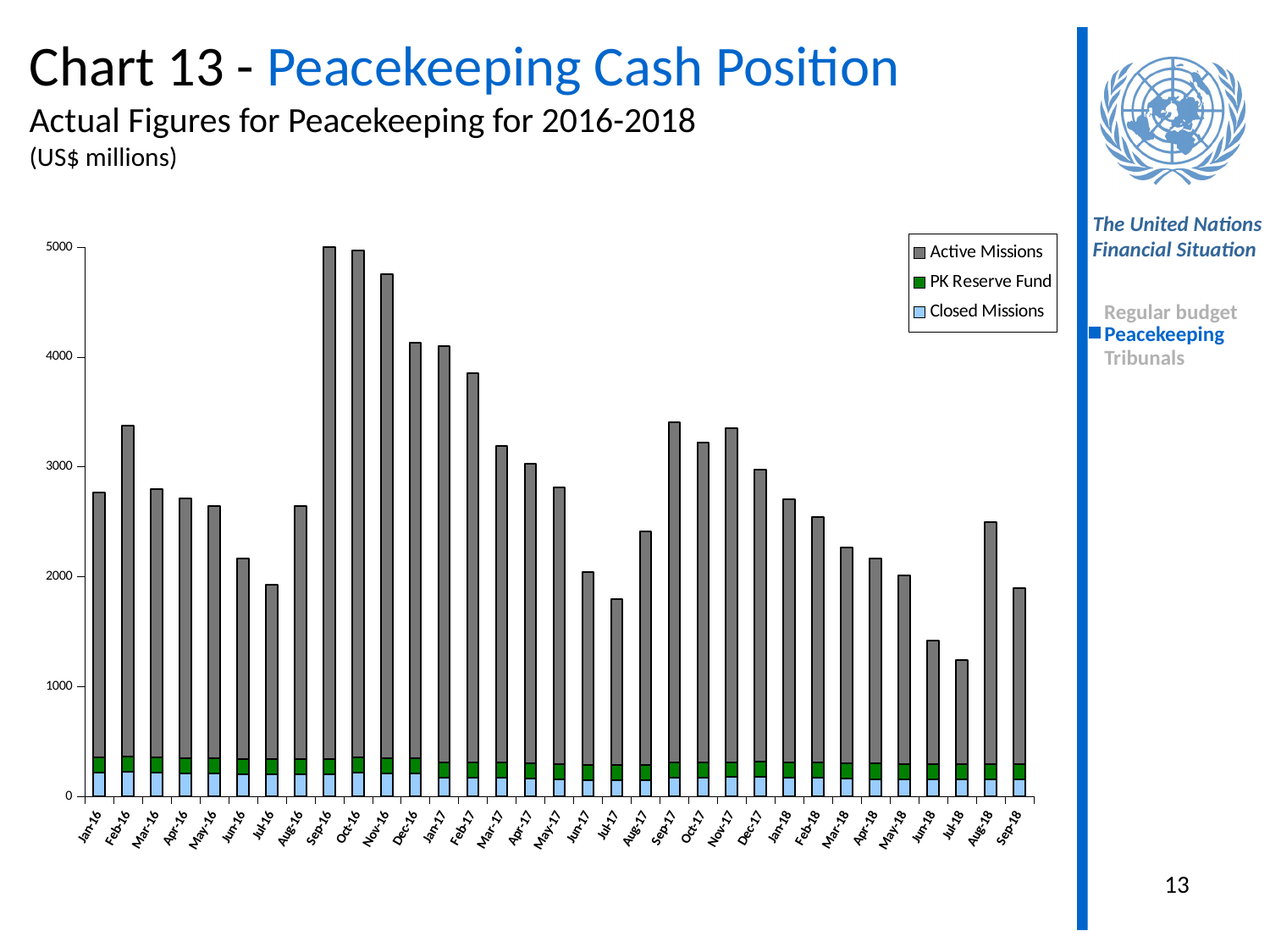
Is the total value for Jul-17 greater or less than 2000? less Is the total value for Feb-16 greater or less than 3000? greater How many series does the legend list? 3 Which month has the lowest total bar? Jul-18 Is the total value for Sep-16 greater or less than 4000? greater Which has the larger total bar, Aug-17 or Sep-17? Sep-17 Which series is shown in green in the legend? PK Reserve Fund How many monthly bars are plotted on the chart? 33 What kind of chart is shown on the slide? Stacked bar chart Which has the larger total bar, Jan-16 or Feb-16? Feb-16 Do the total bars generally rise or fall from Sep-16 to Jul-17? fall